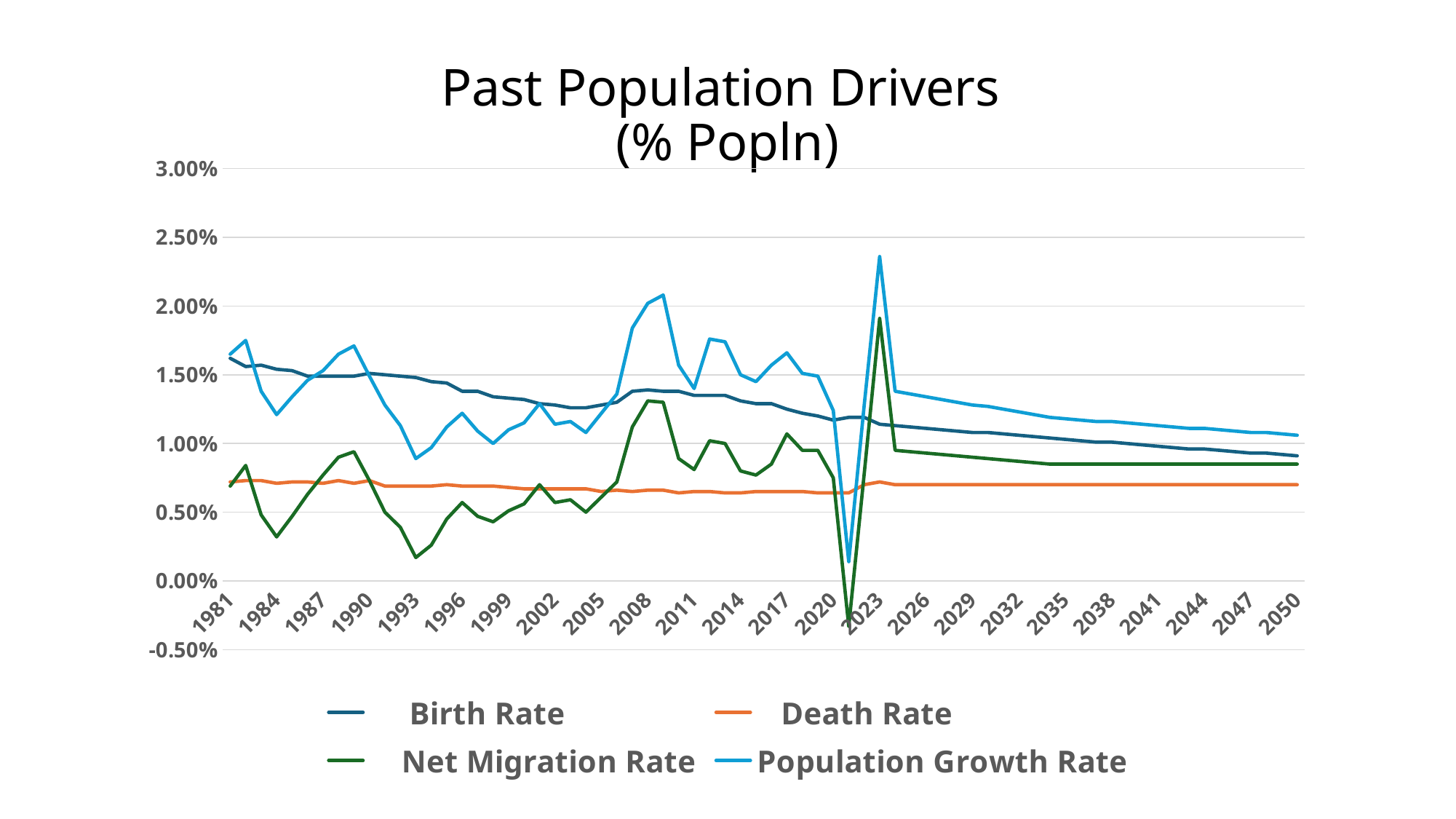
What kind of chart is shown on the slide? Line chart In 2050, which is larger: the Population Growth Rate or the Death Rate? Population Growth Rate Does the Birth Rate rise or fall from 1981 to 2050? fall Is the lowest value of the Net Migration Rate greater or less than 0.00%? less How many year labels are shown on the x axis? 24 Which series is drawn in orange? Death Rate How many series does the legend list? 4 Is the Death Rate in 2050 greater or less than 1.00%? less What is the title of the chart? Past Population Drivers (% Popln) Is the Birth Rate in 1981 greater or less than 1.50%? greater Which series reaches the highest value anywhere on the chart? Population Growth Rate